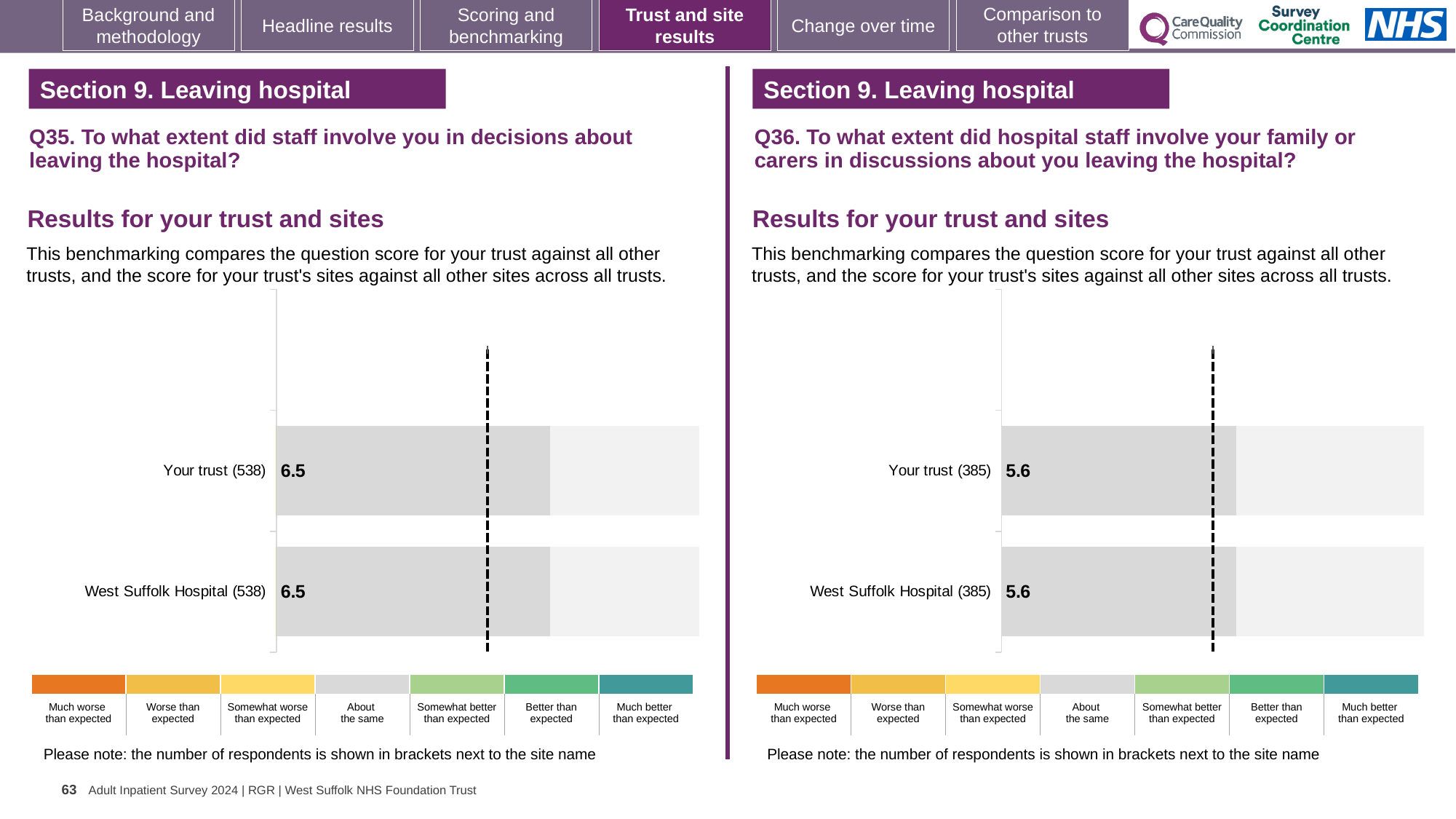
Is the score for Your trust on the left chart (Q35) larger or smaller than the score for Your trust on the right chart (Q36)? Larger What kind of chart is used on the left (Q35)? Bar chart On the left chart (Q35), how many respondents are shown in brackets for Your trust? 538 On the right chart (Q36), how many respondents are shown in brackets for West Suffolk Hospital? 385 On the right chart (Q36), what is the difference between the score for Your trust and the score for West Suffolk Hospital? 0 On the left chart (Q35), what is the difference between the score for Your trust and the score for West Suffolk Hospital? 0 On the right chart (Q36), what is the score for Your trust? 5.6 How many bars are plotted on the right chart (Q36)? 2 On the left chart (Q35), what is the score for West Suffolk Hospital? 6.5 On the left chart (Q35), what is the score for Your trust? 6.5 How many bars are plotted on the left chart (Q35)? 2 On the right chart (Q36), what is the score for West Suffolk Hospital? 5.6